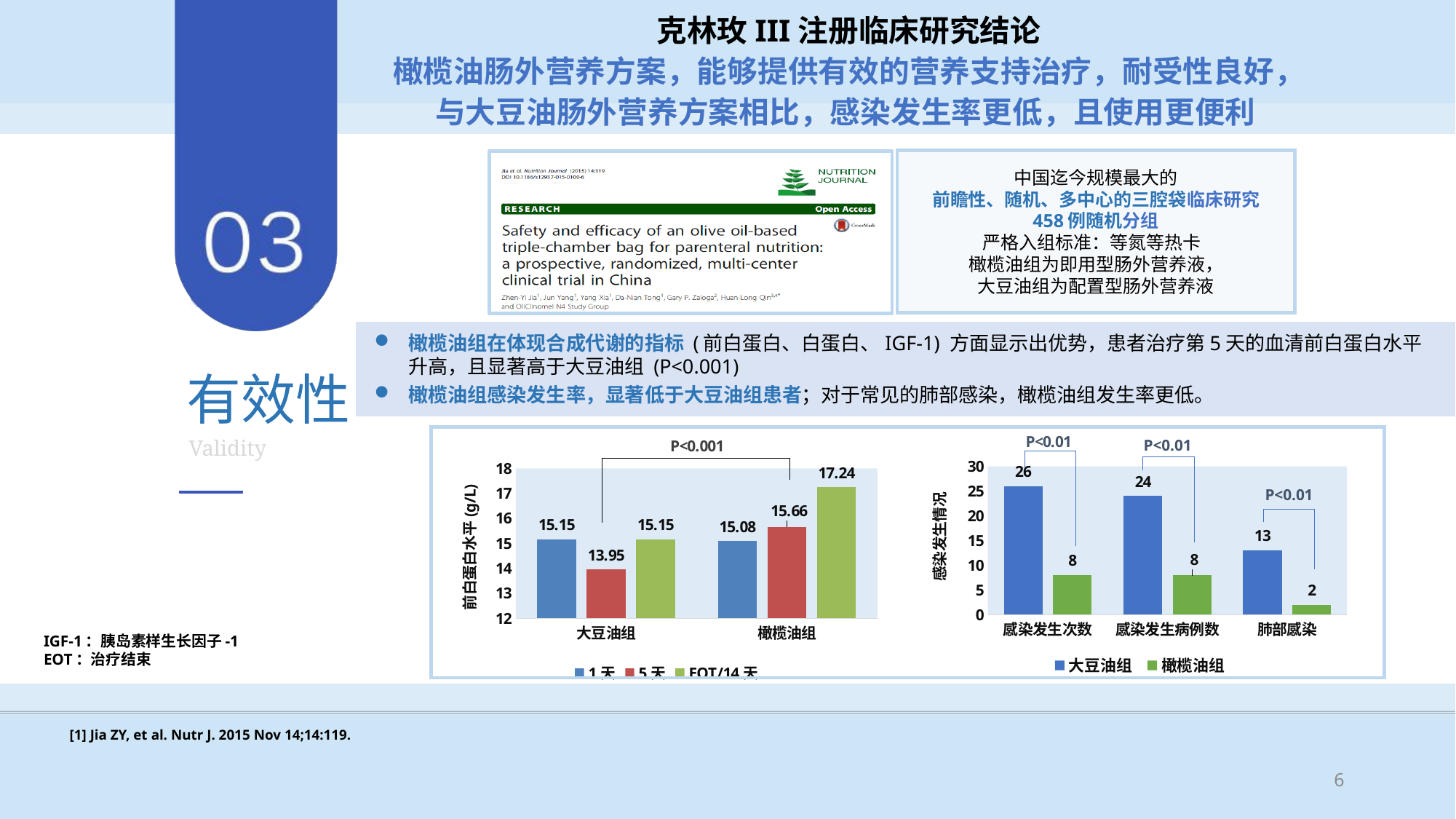
What type of chart is the right chart (感染发生情况)? Bar chart In the left chart (前白蛋白水平), what is the value for the EOT/14 天 series in the 橄榄油组 category? 17.24 In the right chart (感染发生情况), what is the difference between 大豆油组 and 橄榄油组 in the 感染发生病例数 category? 16 In the right chart (感染发生情况), what is the value for 大豆油组 in the 感染发生次数 category? 26 In the right chart (感染发生情况), which group has the larger value for 肺部感染, 大豆油组 or 橄榄油组? 大豆油组 In the right chart (感染发生情况), what is the value for 橄榄油组 in the 肺部感染 category? 2 In the right chart (感染发生情况), how many categories are shown on the x axis? 3 In the left chart (前白蛋白水平), what is the value for the 5 天 series in the 大豆油组 category? 13.95 In the left chart (前白蛋白水平), what is the difference between the EOT/14 天 value and the 1 天 value for the 橄榄油组 category? 2.16 In the left chart (前白蛋白水平), which bar is the highest overall? EOT/14 天 in 橄榄油组 (17.24) In the left chart (前白蛋白水平), how many series does the legend list? 3 In the left chart (前白蛋白水平), what is the value for the 5 天 series in the 橄榄油组 category? 15.66